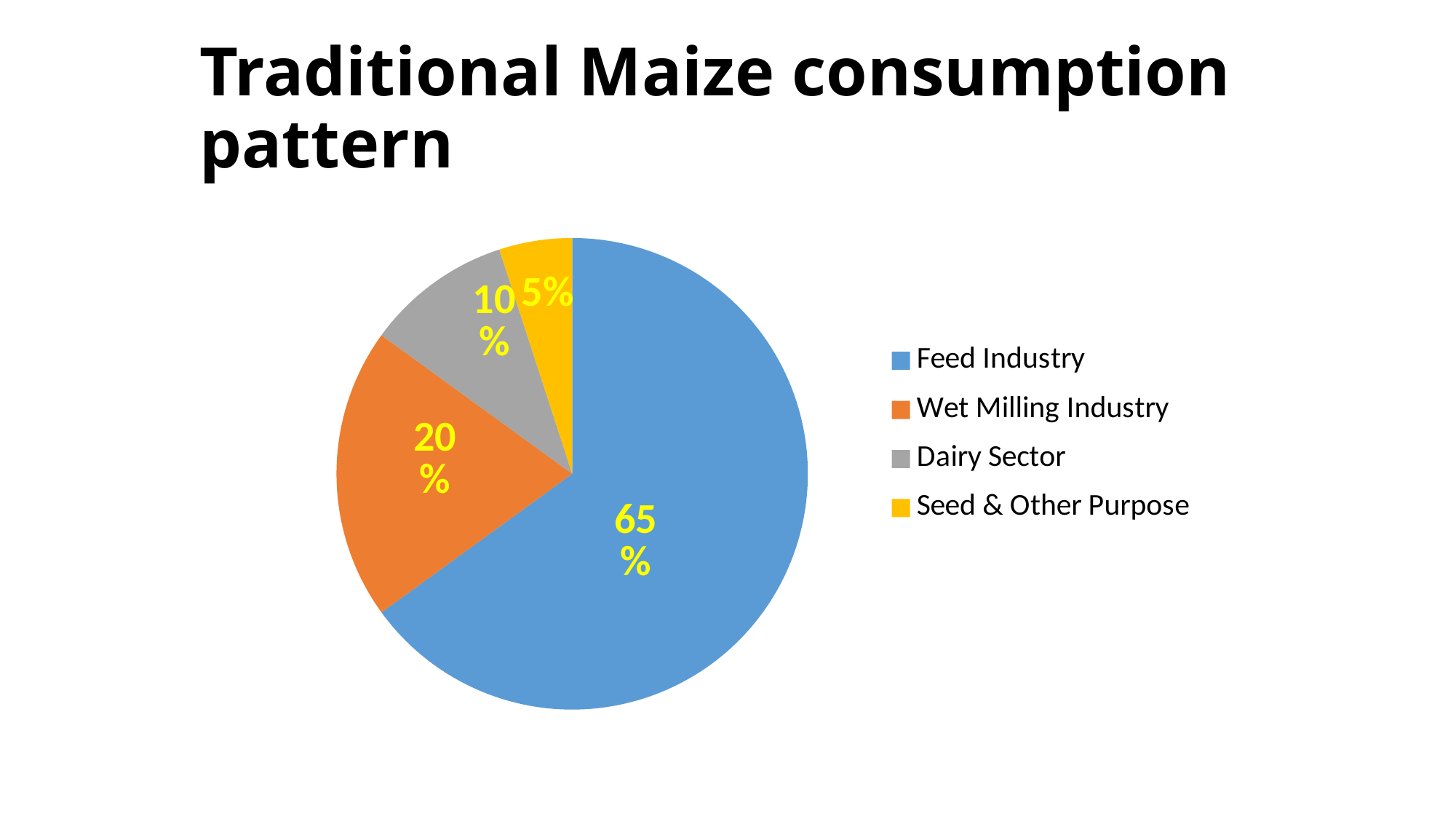
How many categories are shown in the pie chart? 4 What is the difference in percentage points between the Dairy Sector and Seed & Other Purpose shares? 5 What share of traditional maize consumption goes to the Feed Industry? 65% Which category has the smallest share of maize consumption? Seed & Other Purpose Which category has the largest share of maize consumption? Feed Industry What type of chart is shown on the slide? Pie chart How many percentage points larger is the Feed Industry share than the Wet Milling Industry share? 45 Which colour represents the Dairy Sector in the pie chart? Grey What is the share of the Dairy Sector in the pie chart? 10% What percentage is shown for Seed & Other Purpose? 5% Which has a larger share, the Wet Milling Industry or the Dairy Sector? Wet Milling Industry What percentage of maize consumption is attributed to the Wet Milling Industry? 20%